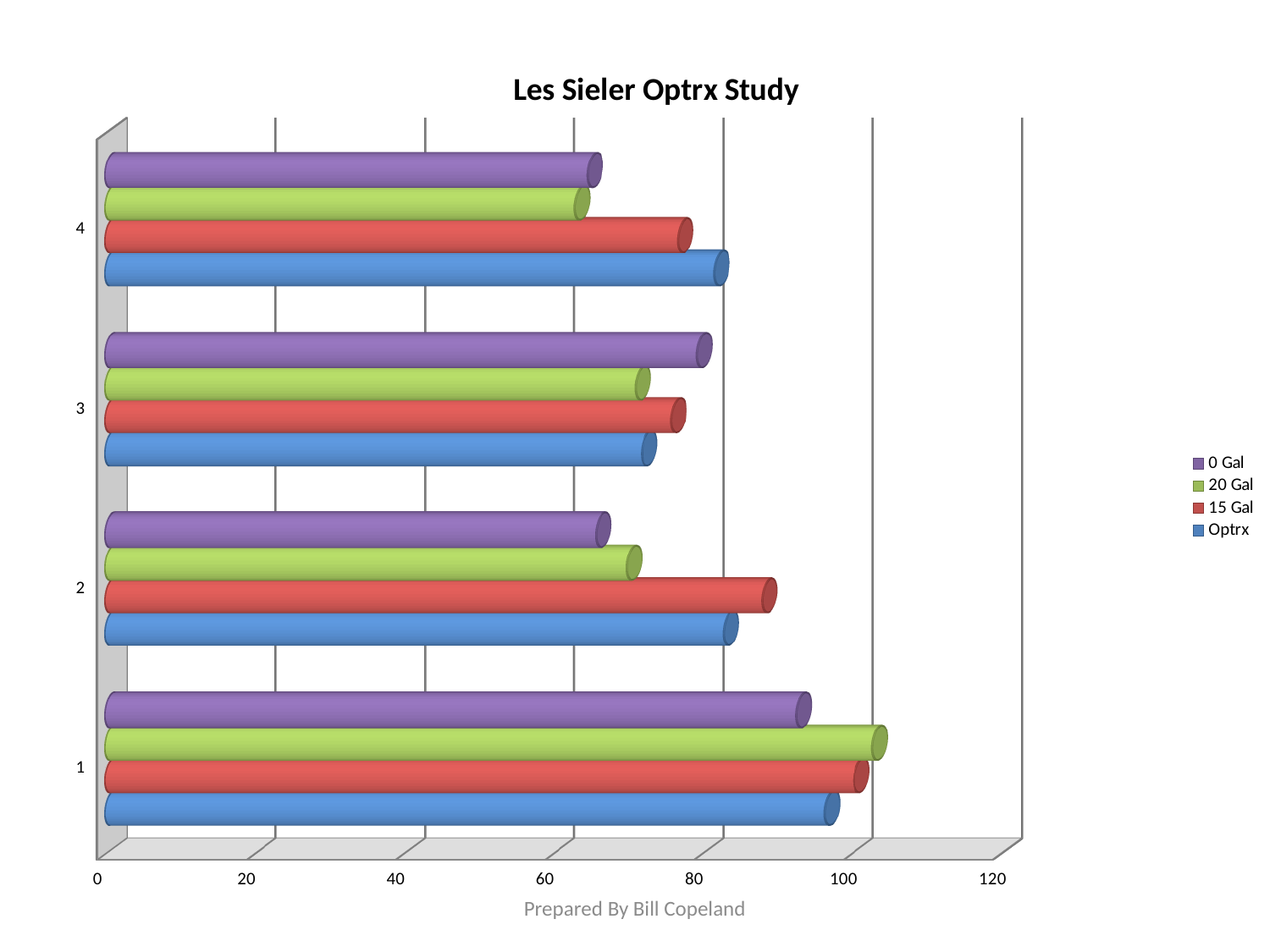
How many categories are shown on the vertical axis? 4 Is the 0 Gal value for category 4 greater or less than 80? less Which series is shown in blue in the legend? Optrx For category 1, which is larger: the 20 Gal value or the 0 Gal value? 20 Gal Is the 20 Gal value for category 1 greater or less than 100? greater Is the 15 Gal value for category 2 greater or less than 80? greater What kind of chart is shown on the slide? Bar chart How many series does the legend list? 4 For category 3, which is larger: the 0 Gal value or the 20 Gal value? 0 Gal What is the title of the chart? Les Sieler Optrx Study For the Optrx series, which category has the lowest value? 3